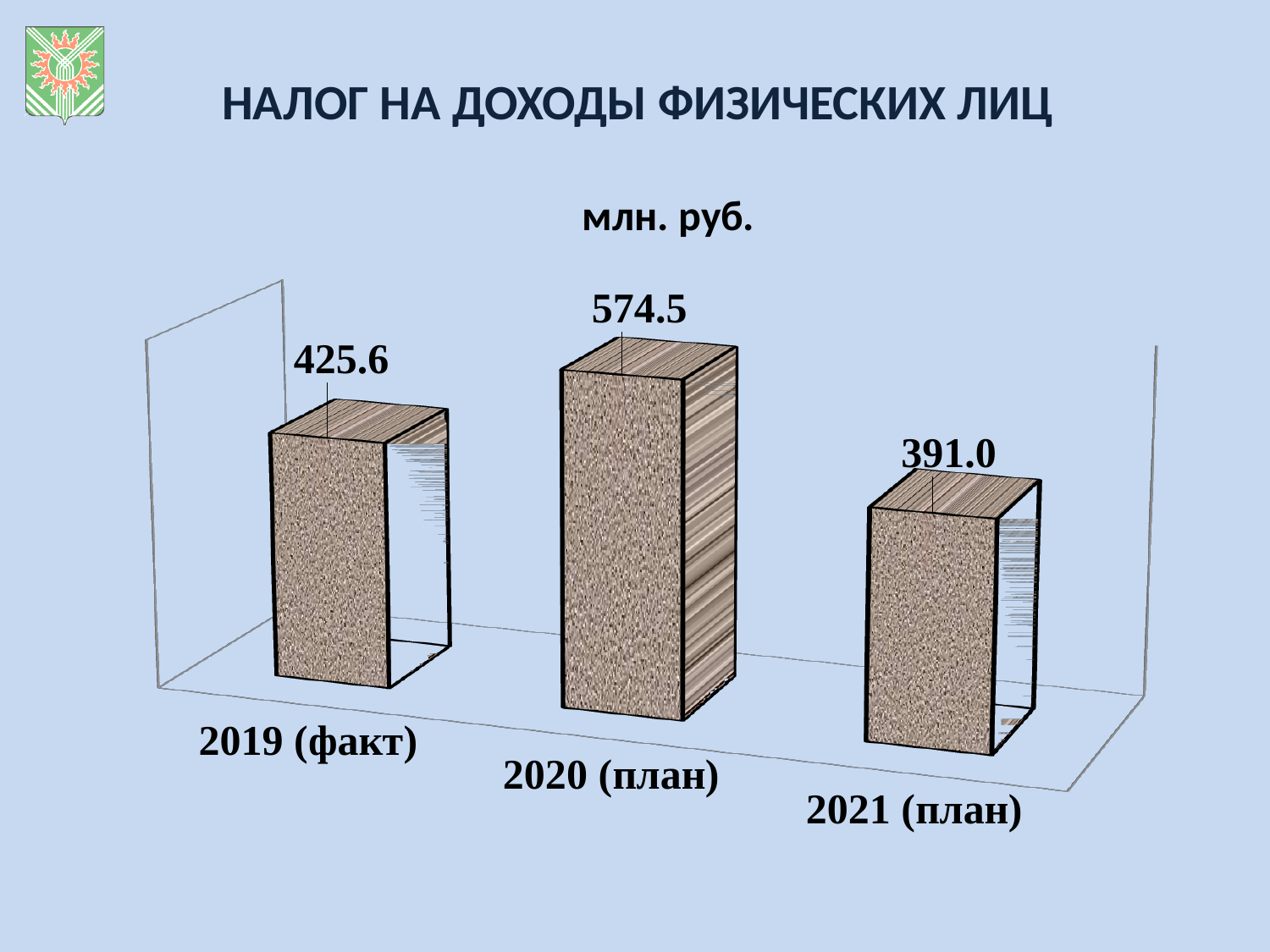
What kind of chart is shown on the slide? bar chart What is the value for 2021 (план)? 391.0 In what units are the values on the chart given? млн. руб. Which category has the highest value? 2020 (план) What is the value for 2020 (план)? 574.5 How many categories are shown in the chart? 3 What is the value for 2019 (факт)? 425.6 What is the difference between the values for 2019 (факт) and 2021 (план)? 34.6 What is the title of the slide? НАЛОГ НА ДОХОДЫ ФИЗИЧЕСКИХ ЛИЦ Which category has the lowest value? 2021 (план) Which is larger, the value for 2019 (факт) or the value for 2021 (план)? 2019 (факт) What is the difference between the values for 2020 (план) and 2019 (факт)? 148.9